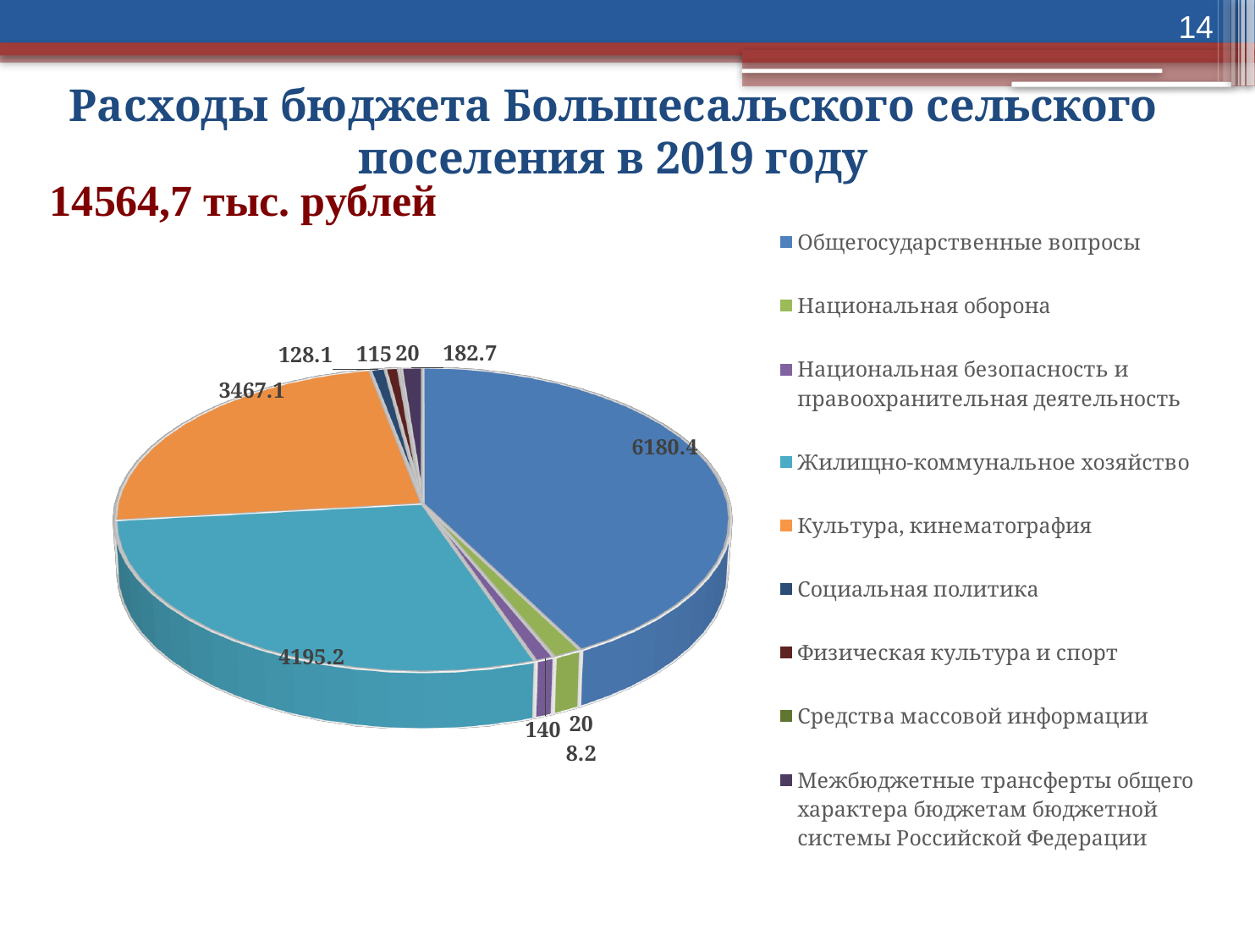
What is the difference between Общегосударственные вопросы and Жилищно-коммунальное хозяйство? 1985.2 What kind of chart is shown on the slide? pie chart Which category has the largest slice of the pie? Общегосударственные вопросы What is the value for Физическая культура и спорт? 115 What is the value for Жилищно-коммунальное хозяйство? 4195.2 What is the value for Социальная политика? 128.1 What total amount of expenditure is stated on the slide? 14564,7 тыс. рублей How many categories does the legend list? 9 What is the value for Культура, кинематография? 3467.1 What is the value for Общегосударственные вопросы? 6180.4 Which is larger: Жилищно-коммунальное хозяйство or Культура, кинематография? Жилищно-коммунальное хозяйство What colour is the slice for Культура, кинематография? orange